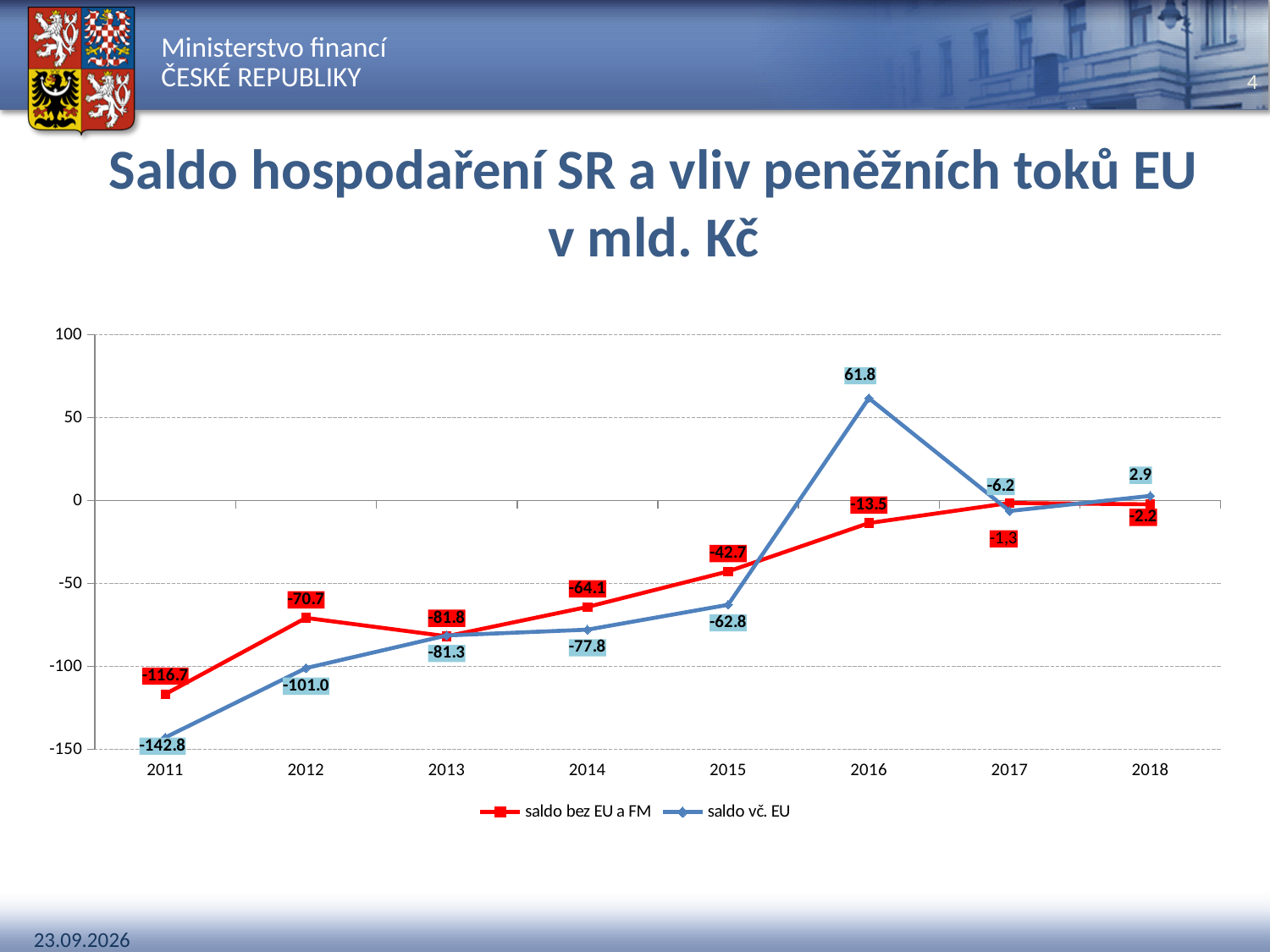
What type of chart is shown on the slide? line chart How many series does the legend list? 2 What is the value of 'saldo vč. EU' in 2018? 2.9 Does 'saldo vč. EU' generally rise or fall from 2011 to 2015? rise Which series has the larger value in 2015, 'saldo bez EU a FM' or 'saldo vč. EU'? saldo bez EU a FM In which year is 'saldo vč. EU' at its lowest? 2011 What colour is the line for 'saldo bez EU a FM'? red How many years are plotted on the x axis? 8 What is the value of 'saldo bez EU a FM' in 2011? -116.7 What is the value of 'saldo vč. EU' in 2016? 61.8 What is the difference between 'saldo vč. EU' and 'saldo bez EU a FM' in 2016? 75.3 In which year is 'saldo bez EU a FM' at its highest? 2017